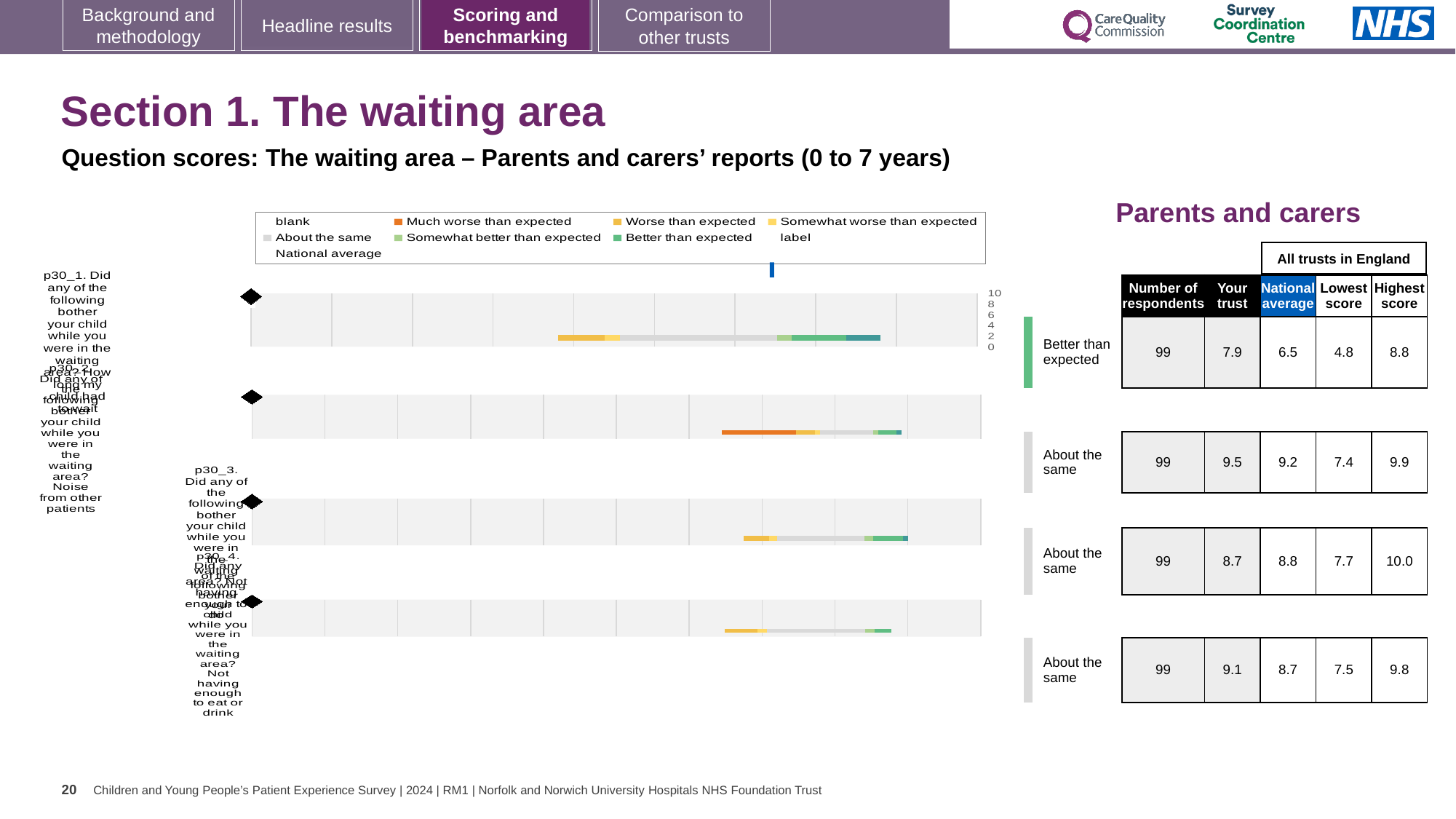
What is the 'Your trust' score for the first question (p30_1, how long my child had to wait)? 7.9 For the third question (p30_3), which is larger: the 'Your trust' score or the national average? National average Which question has the lowest 'Your trust' score? p30_1 (how long my child had to wait), 7.9 Which benchmark category is shown for the first question (p30_1)? Better than expected What is the lowest score across all trusts in England for the fourth question (p30_4, not having enough to eat or drink)? 7.5 What is the number of respondents for the second question (p30_2, noise from other patients)? 99 What is the highest score across all trusts in England for the third question (p30_3, not having enough to do)? 10.0 What kind of chart is shown on the slide? bar chart What is the difference between the 'Your trust' score and the national average for the first question (p30_1)? 1.4 Which question has the highest 'Your trust' score? p30_2 (noise from other patients), 9.5 How many question bars are plotted in the chart? 4 What is the national average score for the first question (p30_1)? 6.5